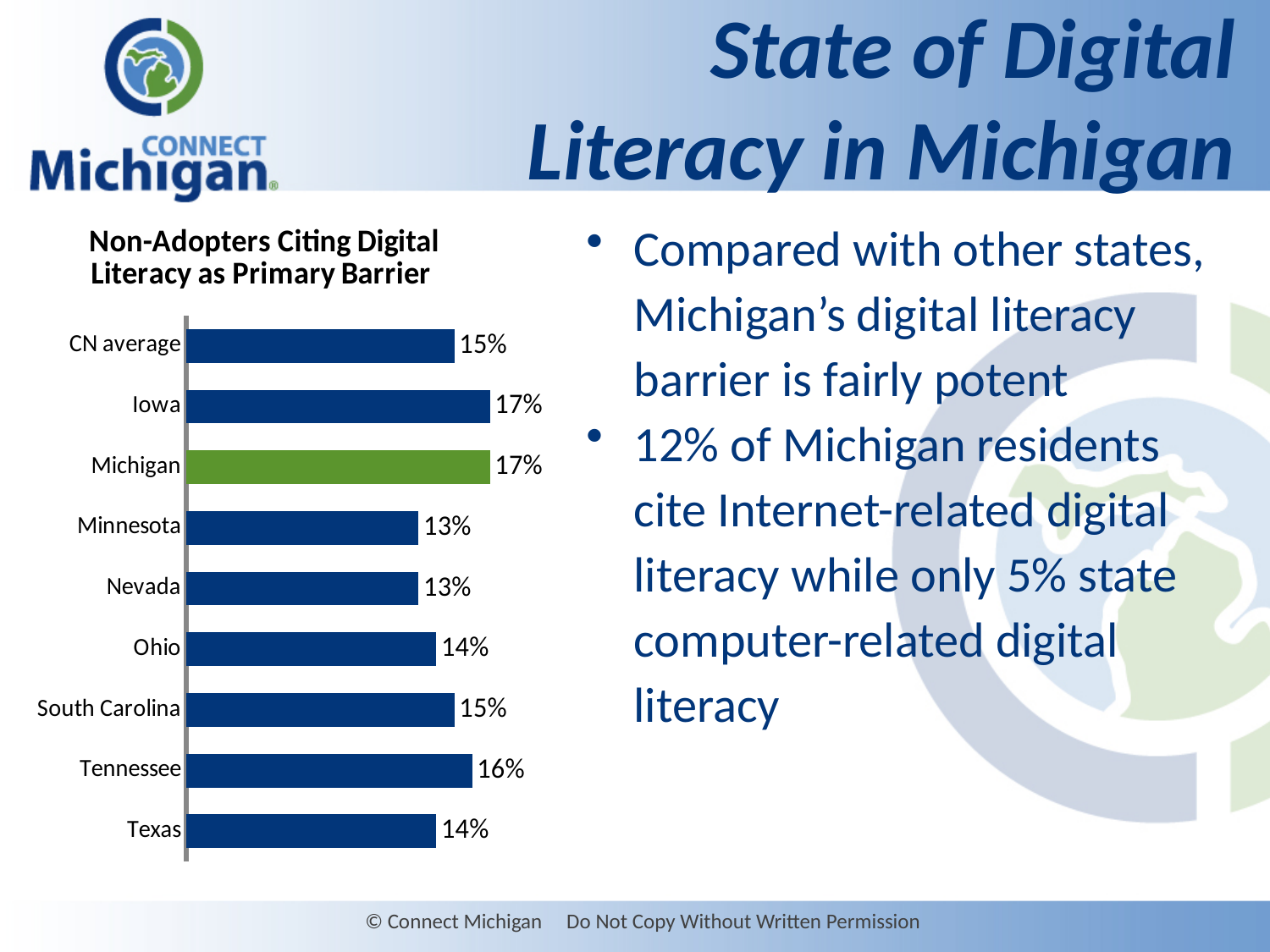
Which bar in the chart is coloured green rather than blue? Michigan What type of chart is shown on the slide? Bar chart Which is larger, the value for Iowa or the value for Nevada? Iowa What is the value shown for Tennessee? 16% What value is shown for Minnesota? 13% What is the difference between the value for Tennessee and the value for Texas? 2 percentage points What value is shown for Texas? 14% Which is larger, the value for Tennessee or the value for Ohio? Tennessee What percentage of non-adopters in Michigan cite digital literacy as the primary barrier? 17% How many categories (bars) are shown in the chart? 9 What is the difference between the value for Michigan and the value for Minnesota? 4 percentage points What is the CN average value shown in the chart? 15%